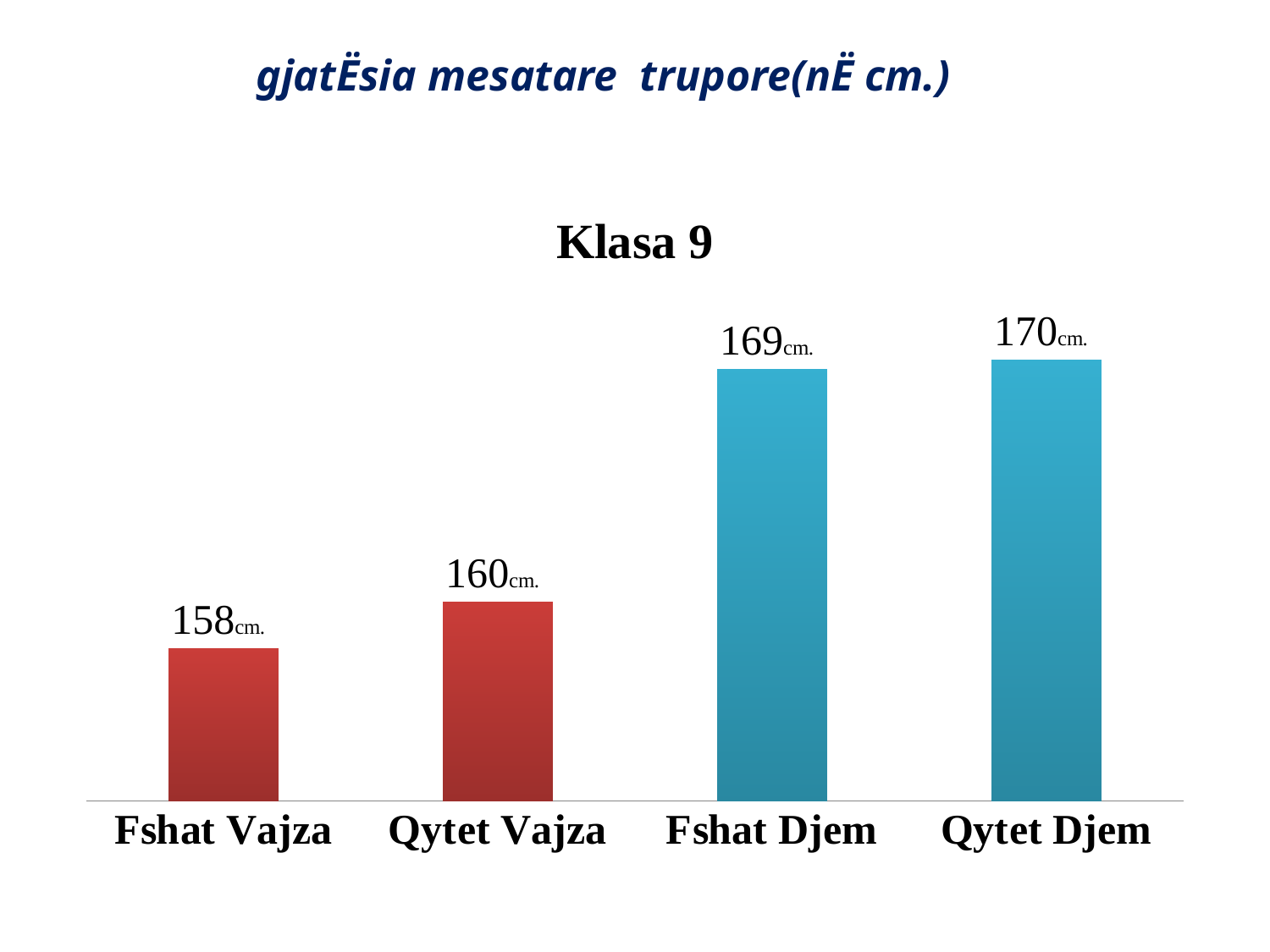
What is the value for Fshat Vajza? 158cm. What is the value for Qytet Djem? 170cm. Which is larger, the value for Fshat Djem or the value for Qytet Vajza? Fshat Djem What is the difference between the values for Qytet Djem and Fshat Vajza? 12 cm What is the title of the chart? Klasa 9 What is the value for Fshat Djem? 169cm. Which category has the lowest value? Fshat Vajza How many categories are shown on the chart? 4 What kind of chart is shown on the slide? Bar chart Which category has the highest value? Qytet Djem What is the value for Qytet Vajza? 160cm. What is the difference between the values for Qytet Vajza and Fshat Vajza? 2 cm